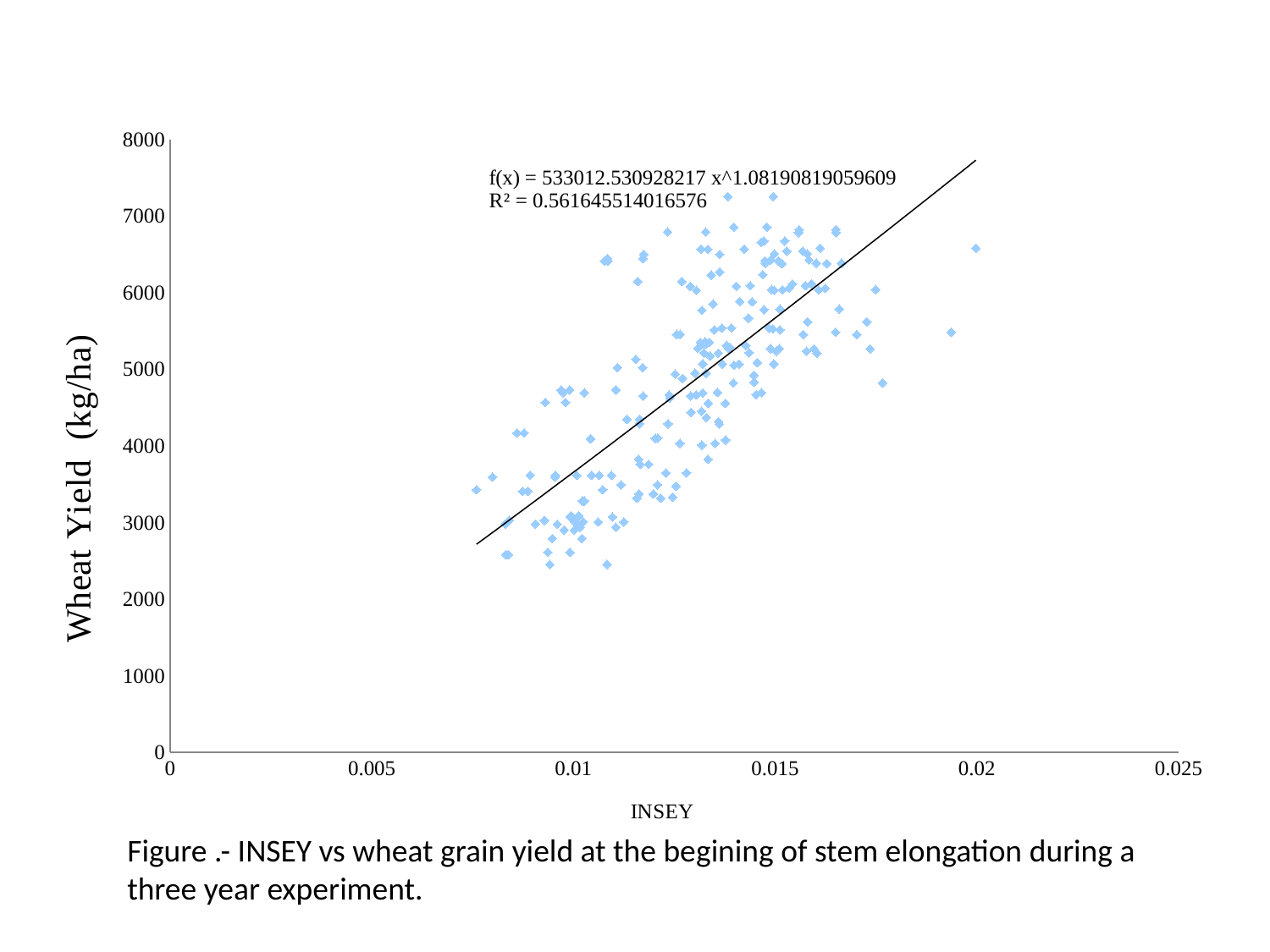
Is the lowest wheat yield value plotted greater or less than 3000? less Is the largest INSEY value plotted greater or less than 0.015? greater What is the label of the y axis? Wheat Yield (kg/ha) What is the maximum value shown on the y axis? 8000 What is the fitted equation printed on the chart? f(x) = 533012.530928217 x^1.08190819059609 As INSEY increases along the x axis, does wheat yield generally rise or fall? rise Is the smallest INSEY value plotted greater or less than 0.01? less What kind of chart is shown on the slide? scatter plot What is the label of the x axis? INSEY What is the R² value printed on the chart? 0.561645514016576